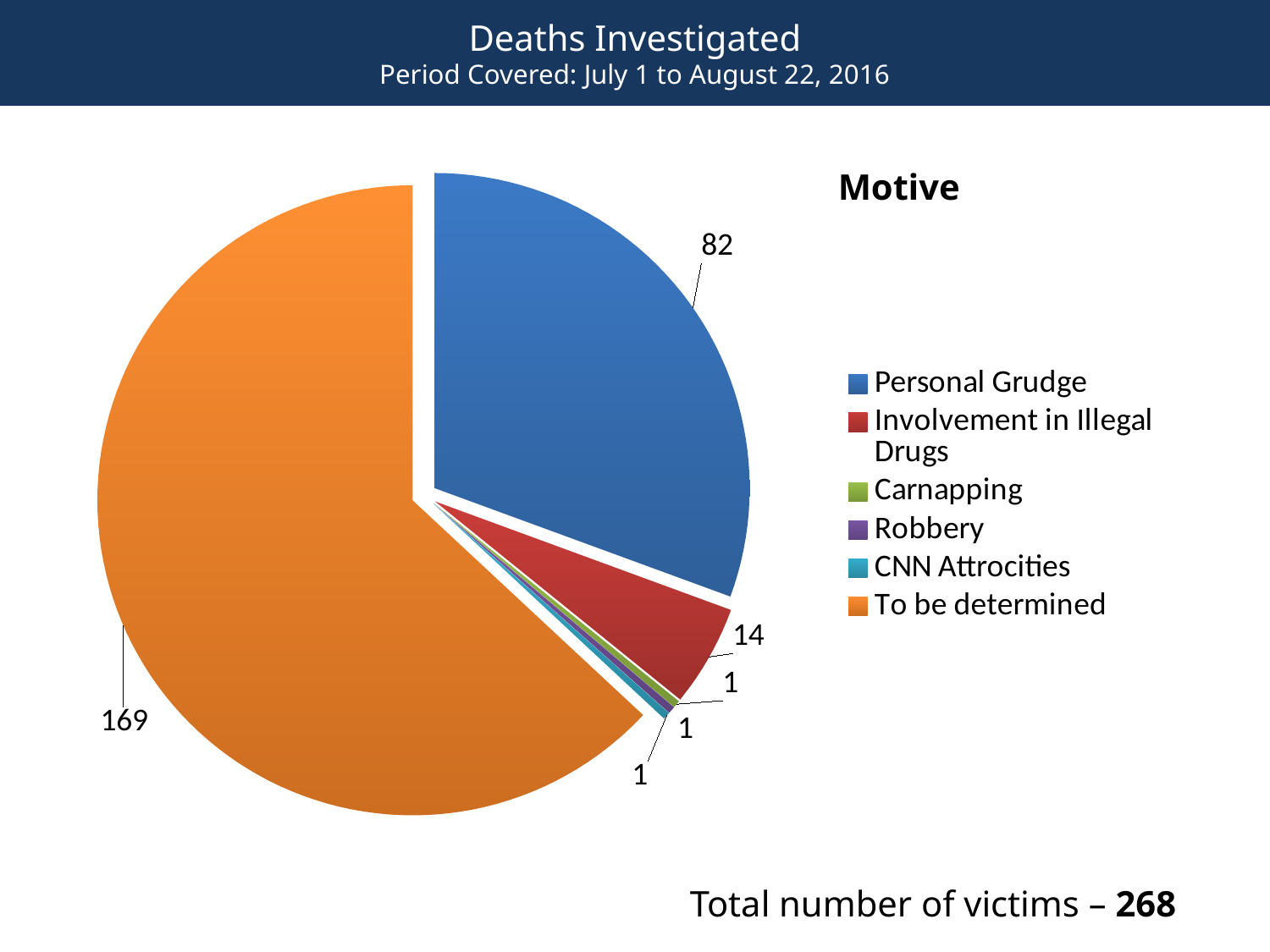
How many categories does the legend list? 6 What type of chart is shown on the slide? pie chart Which is larger, Personal Grudge or Involvement in Illegal Drugs? Personal Grudge What is the title of the chart? Motive What is the difference between Personal Grudge and Involvement in Illegal Drugs? 68 What is the value for Personal Grudge? 82 Which motive has the largest slice of the pie? To be determined What is the value for Involvement in Illegal Drugs? 14 What is the total number of victims stated on the slide? 268 What is the value for To be determined? 169 What is the difference between the To be determined value and the Personal Grudge value? 87 What colour is the To be determined slice? orange